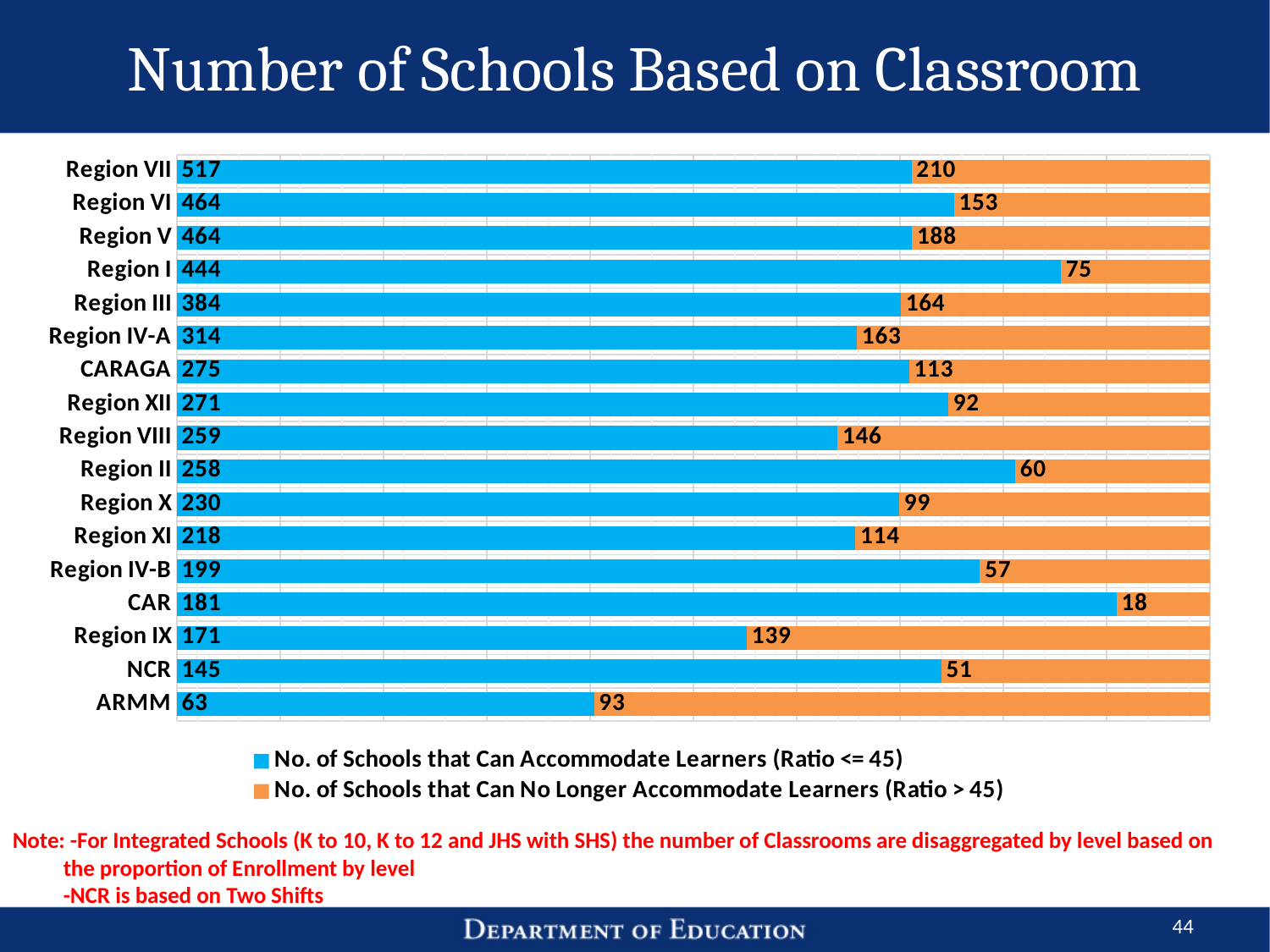
How many schools in Region VII can accommodate learners (Ratio <= 45)? 517 What type of chart is shown on the slide? Stacked bar chart How many regions are shown in the chart? 17 What is the difference between the number of schools that can accommodate learners and those that can no longer accommodate learners in Region I? 369 How many schools in ARMM can no longer accommodate learners (Ratio > 45)? 93 How many series does the legend list? 2 Which region has the highest number of schools that can accommodate learners (Ratio <= 45)? Region VII Which region has the lowest number of schools that can accommodate learners (Ratio <= 45)? ARMM Which is larger in Region IX: the number of schools that can accommodate learners or the number that can no longer accommodate learners? No. of Schools that Can Accommodate Learners (Ratio <= 45) How many schools in NCR can accommodate learners (Ratio <= 45)? 145 What is the total number of schools shown for Region VII? 727 Which region has the lowest number of schools that can no longer accommodate learners (Ratio > 45)? CAR